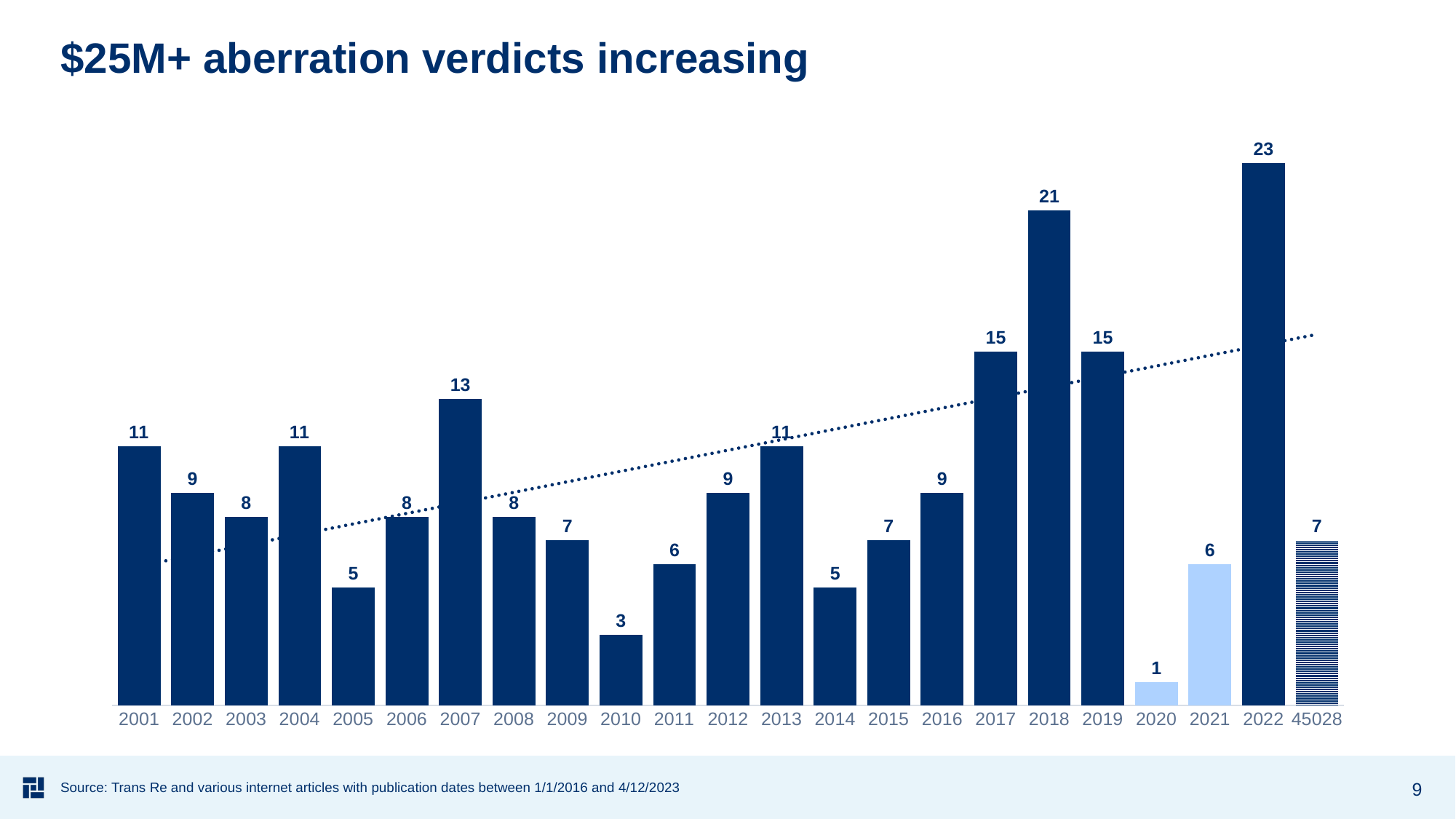
What is the difference between the values for 2007 and 2005? 8 Which year has the highest value? 2022 Does the dotted trend line rise or fall from left to right? rise What is the difference between the values for 2022 and 2018? 2 What is the value for 2010? 3 What is the title of the chart? $25M+ aberration verdicts increasing Which is larger, the value for 2017 or the value for 2013? 2017 What kind of chart is shown on the slide? bar chart What is the value for 2021? 6 What is the value for 2018? 21 How many bars are plotted on the chart? 23 Which year has the lowest value? 2020